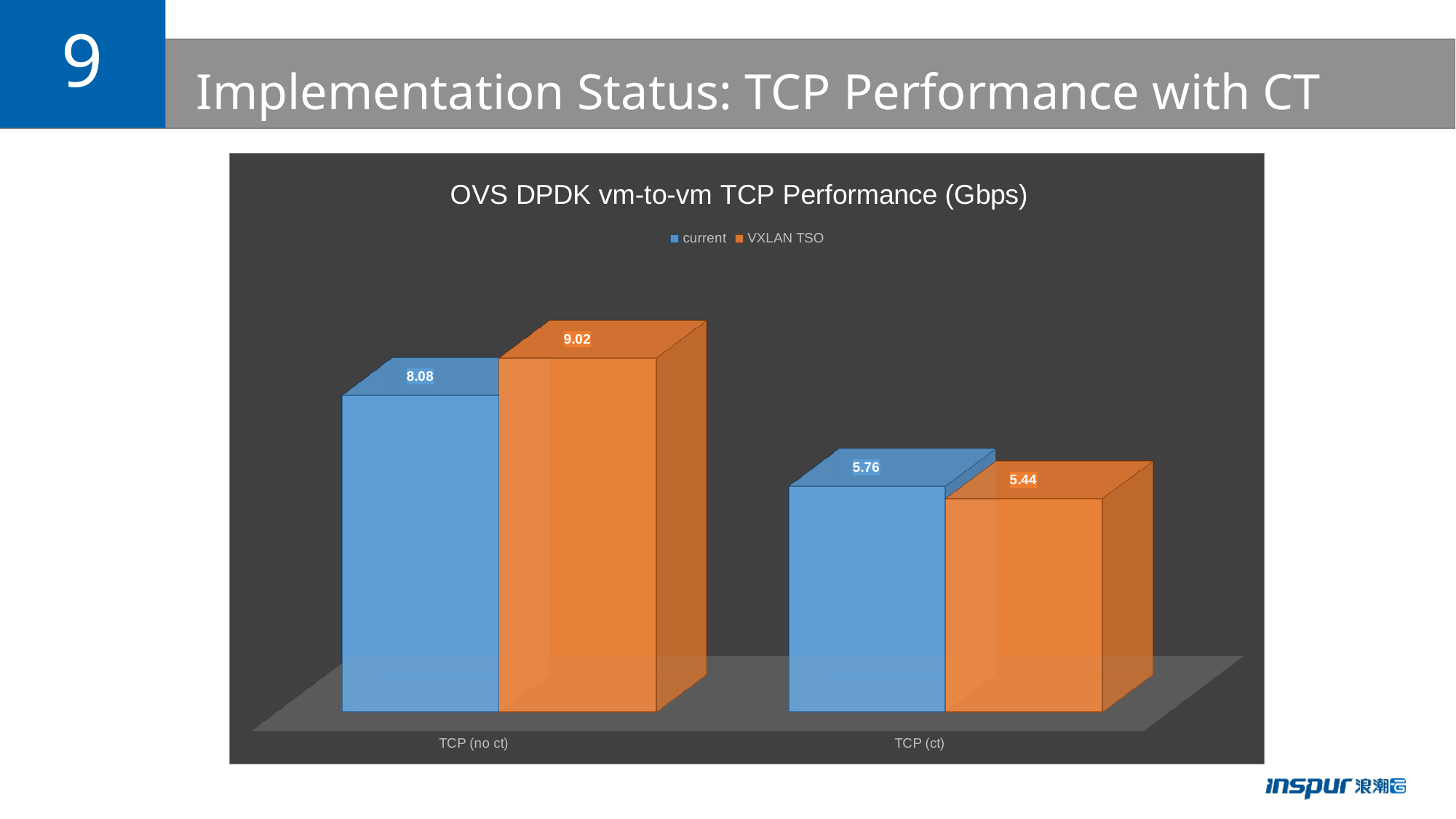
How many categories are shown on the x axis? 2 Which bar has the highest value on the chart? VXLAN TSO, TCP (no ct) What is the value for 'current' in the TCP (ct) category? 5.76 What is the title of the chart? OVS DPDK vm-to-vm TCP Performance (Gbps) What is the value for 'current' in the TCP (no ct) category? 8.08 Which bar has the lowest value on the chart? VXLAN TSO, TCP (ct) How many series does the legend list? 2 What is the value for 'VXLAN TSO' in the TCP (ct) category? 5.44 What is the value for 'VXLAN TSO' in the TCP (no ct) category? 9.02 What is the difference between the 'VXLAN TSO' and 'current' values in the TCP (no ct) category? 0.94 In the TCP (ct) category, which series has the larger value, 'current' or 'VXLAN TSO'? current What is the difference between the 'current' and 'VXLAN TSO' values in the TCP (ct) category? 0.32